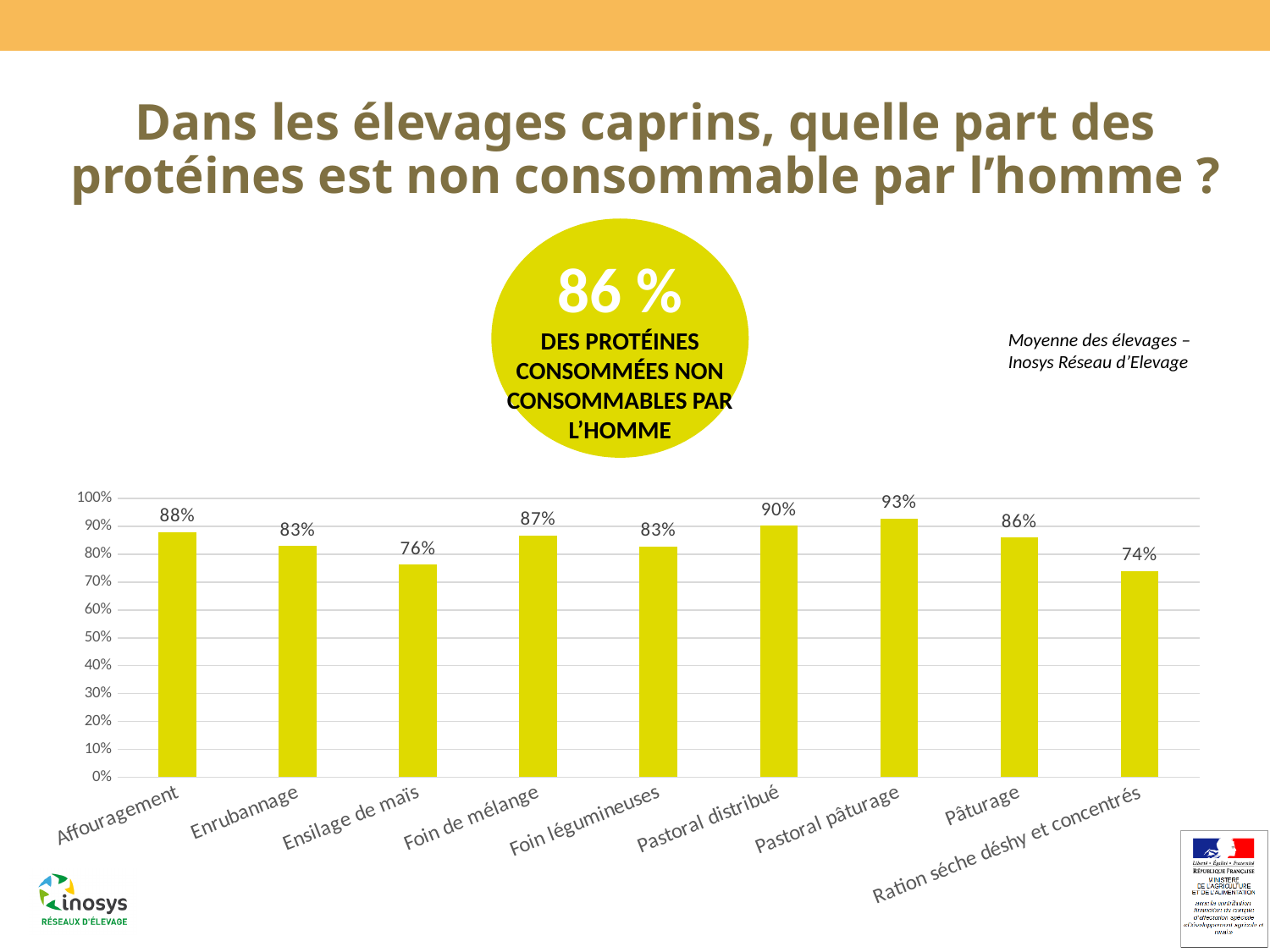
What is the value for Ensilage de maïs? 76% What is the difference between the values for Pastoral pâturage and Ensilage de maïs? 17% Which category has the lowest value? Ration sèche déshy et concentrés What is the value for Ration sèche déshy et concentrés? 74% What is the difference between the values for Affouragement and Enrubannage? 5% What is the value for Affouragement? 88% How many categories are shown on the x axis? 9 What is the value for Pastoral distribué? 90% What is the value for Pâturage? 86% What kind of chart is shown on the slide? bar chart Which is larger, the value for Foin de mélange or the value for Foin légumineuses? Foin de mélange Which category has the highest value? Pastoral pâturage